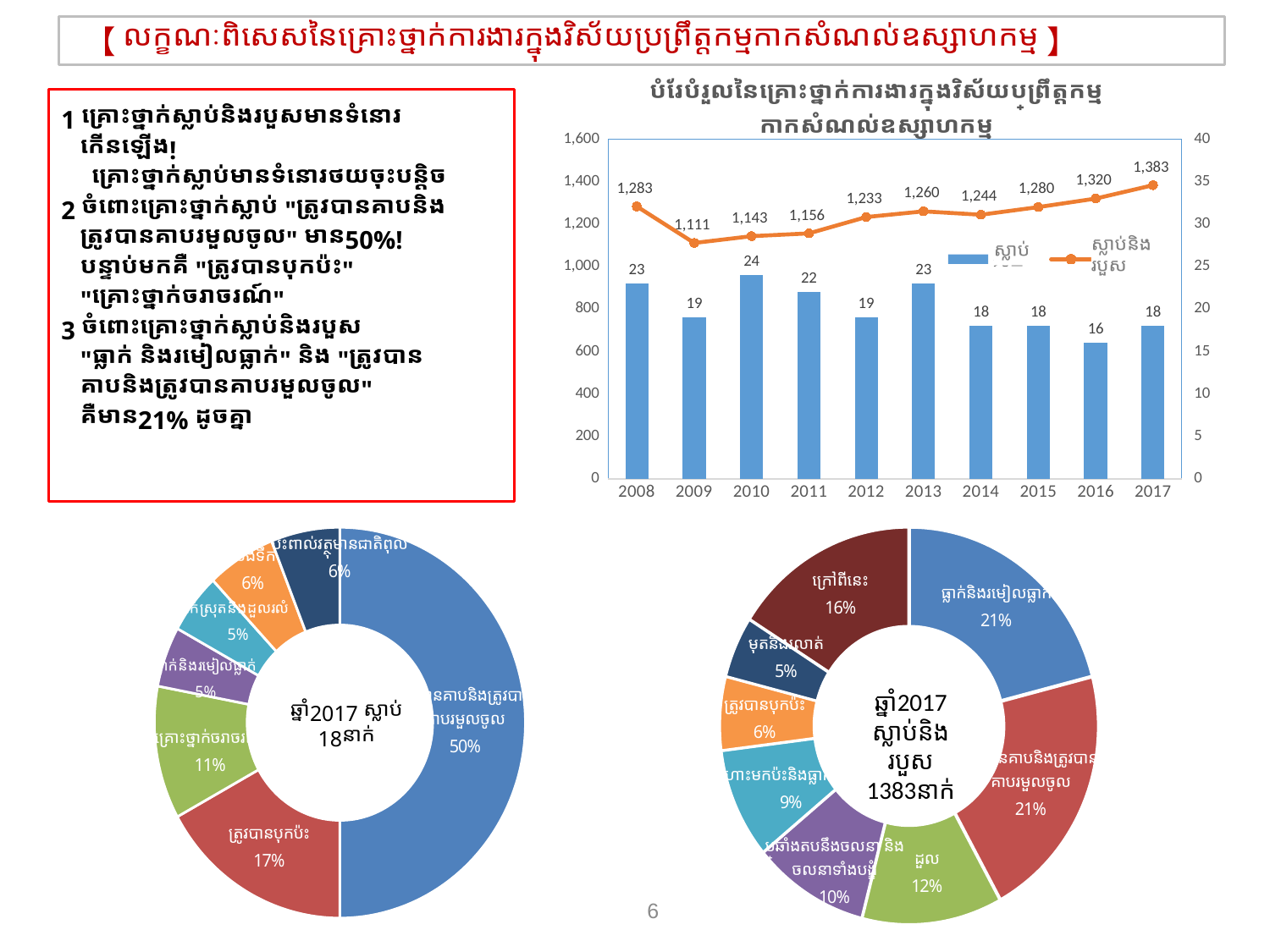
In the bottom-right donut chart (ឆ្នាំ2017 ស្លាប់និងរបួស 1383នាក់), what share does the slice labelled ក្រៅពីនេះ have? 16% In the top-right chart, how many series does the legend list? 2 What kind of chart is shown at the bottom right of the slide? donut (pie) chart In the top-right chart, does the line series (ស្លាប់និងរបួស) generally rise or fall from 2009 to 2017? rise In the top-right chart, what is the value of the line series (ស្លាប់និងរបួស) for 2017? 1,383 In the top-right chart, what is the difference between the line values for 2017 and 2008? 100 In the bottom-left donut chart (ឆ្នាំ2017 ស្លាប់ 18នាក់), what share does the largest slice have? 50% In the top-right chart, how many years are shown on the x axis? 10 In the top-right chart, what is the bar value (ស្លាប់) for 2010? 24 In the top-right chart, which year has the lowest bar value (ស្លាប់)? 2016 In the top-right chart, is the bar value for 2009 larger or smaller than the bar value for 2010? smaller In the top-right chart, which year has the highest value on the line series (ស្លាប់និងរបួស)? 2017